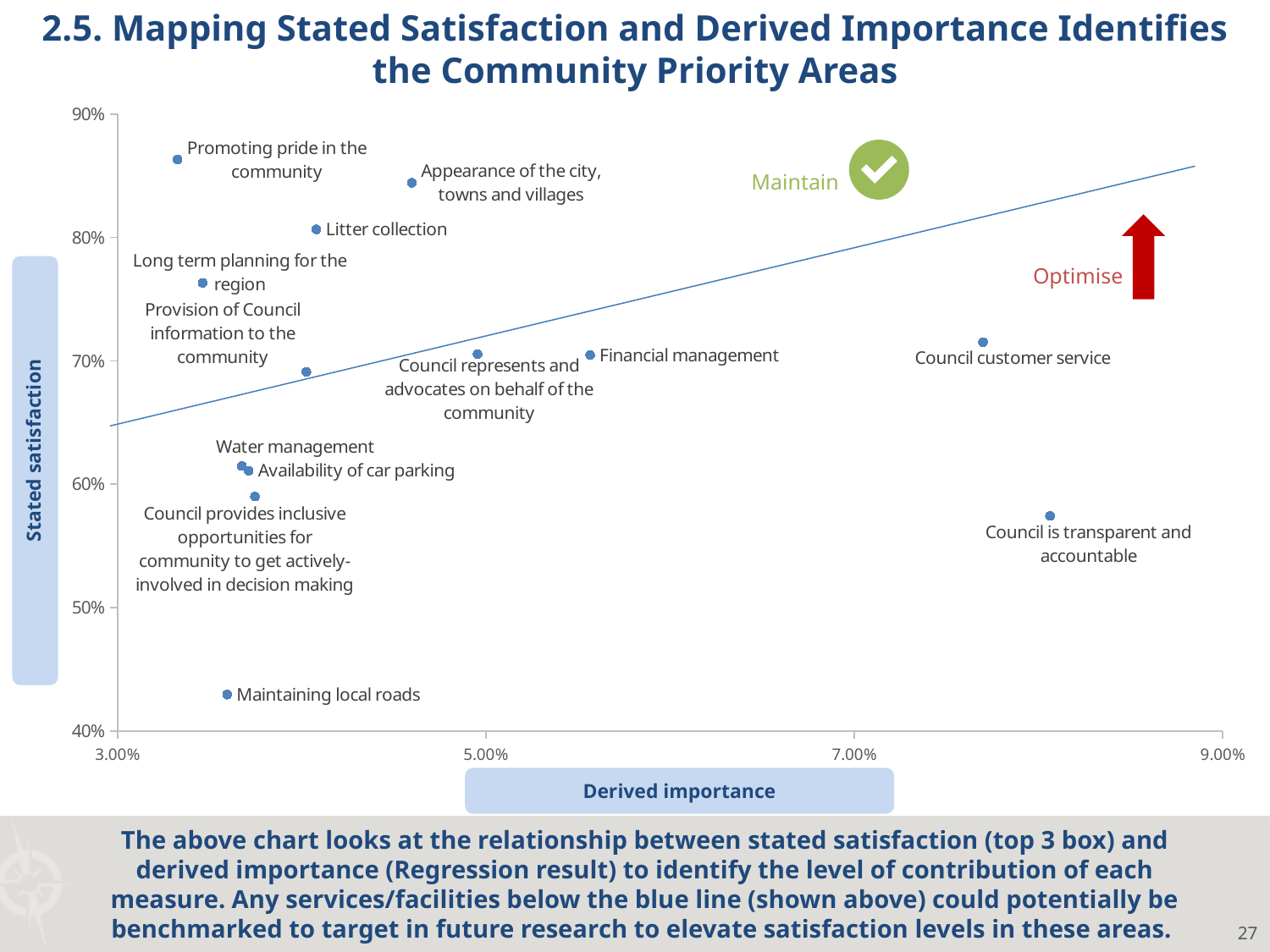
Is the stated satisfaction for Council is transparent and accountable greater or less than 60%? less Is the stated satisfaction for Litter collection greater or less than 80%? greater Which has higher stated satisfaction: Litter collection or Long term planning for the region? Litter collection Which service has the highest derived importance on the chart? Council is transparent and accountable Is the stated satisfaction for Maintaining local roads greater or less than 50%? less Which service has the highest stated satisfaction on the chart? Promoting pride in the community What kind of chart is shown on the slide? Scatter chart How many labelled services are plotted on the chart? 13 What is the label on the horizontal axis of the chart? Derived importance Which service has the lowest stated satisfaction on the chart? Maintaining local roads Which has higher stated satisfaction: Council customer service or Council is transparent and accountable? Council customer service